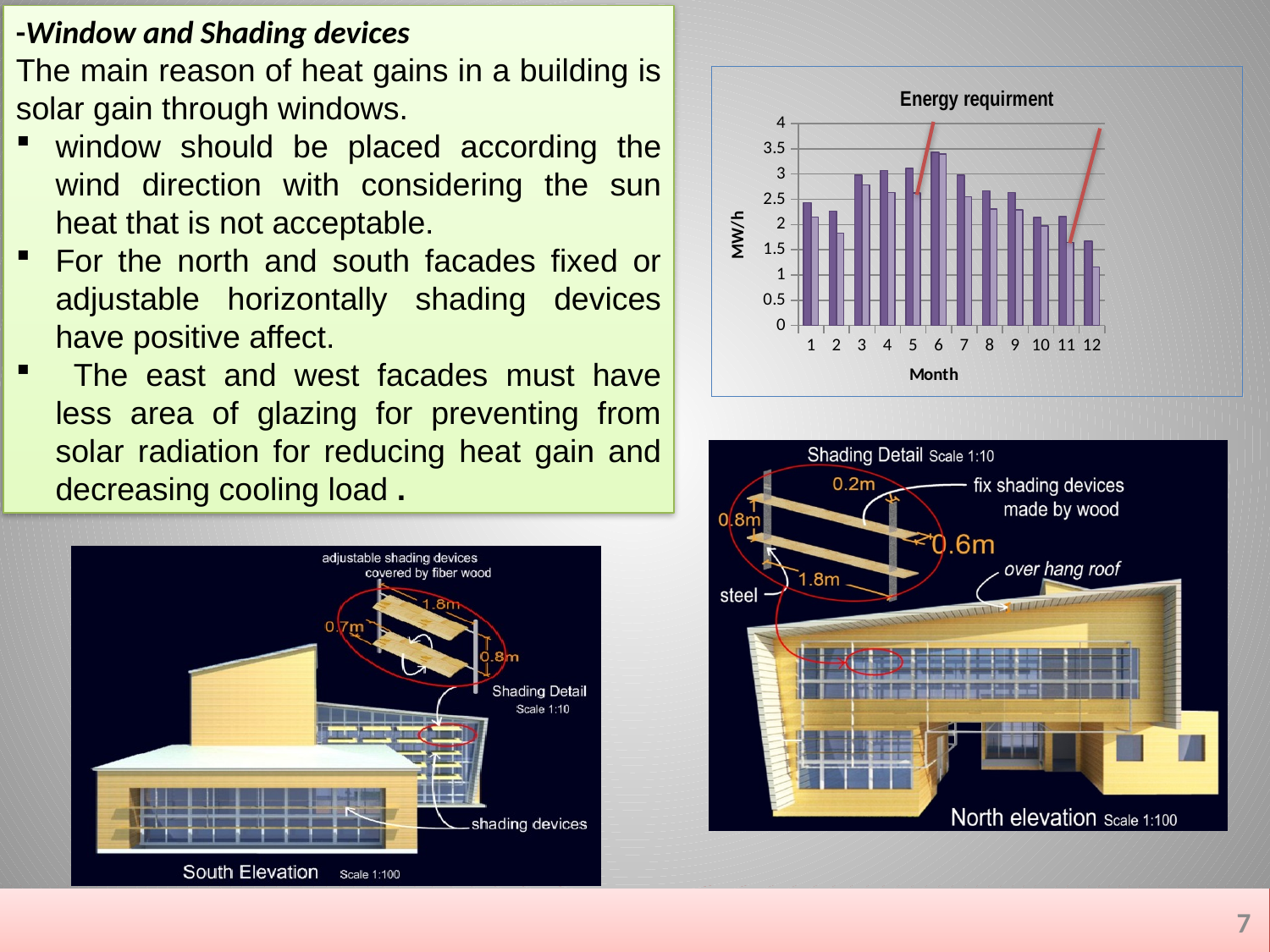
What is the label of the y axis of the "Energy requirment" chart? MW/h In the "Energy requirment" chart, which month has the larger taller bar, month 6 or month 2? 6 How many months are shown on the x axis of the "Energy requirment" chart? 12 In the "Energy requirment" chart, is the taller bar for month 3 greater or less than 2.5? greater In the "Energy requirment" chart, which month has the highest energy requirement? 6 In the "Energy requirment" chart, is the shorter bar for month 12 greater or less than 1.5? less What is the title of the chart on the slide? Energy requirment In the "Energy requirment" chart, do the values generally rise or fall from month 6 to month 12? fall In the "Energy requirment" chart, is the taller bar for month 1 greater or less than 3? less What kind of chart is the "Energy requirment" chart? bar chart In the "Energy requirment" chart, which month has the lowest energy requirement? 12